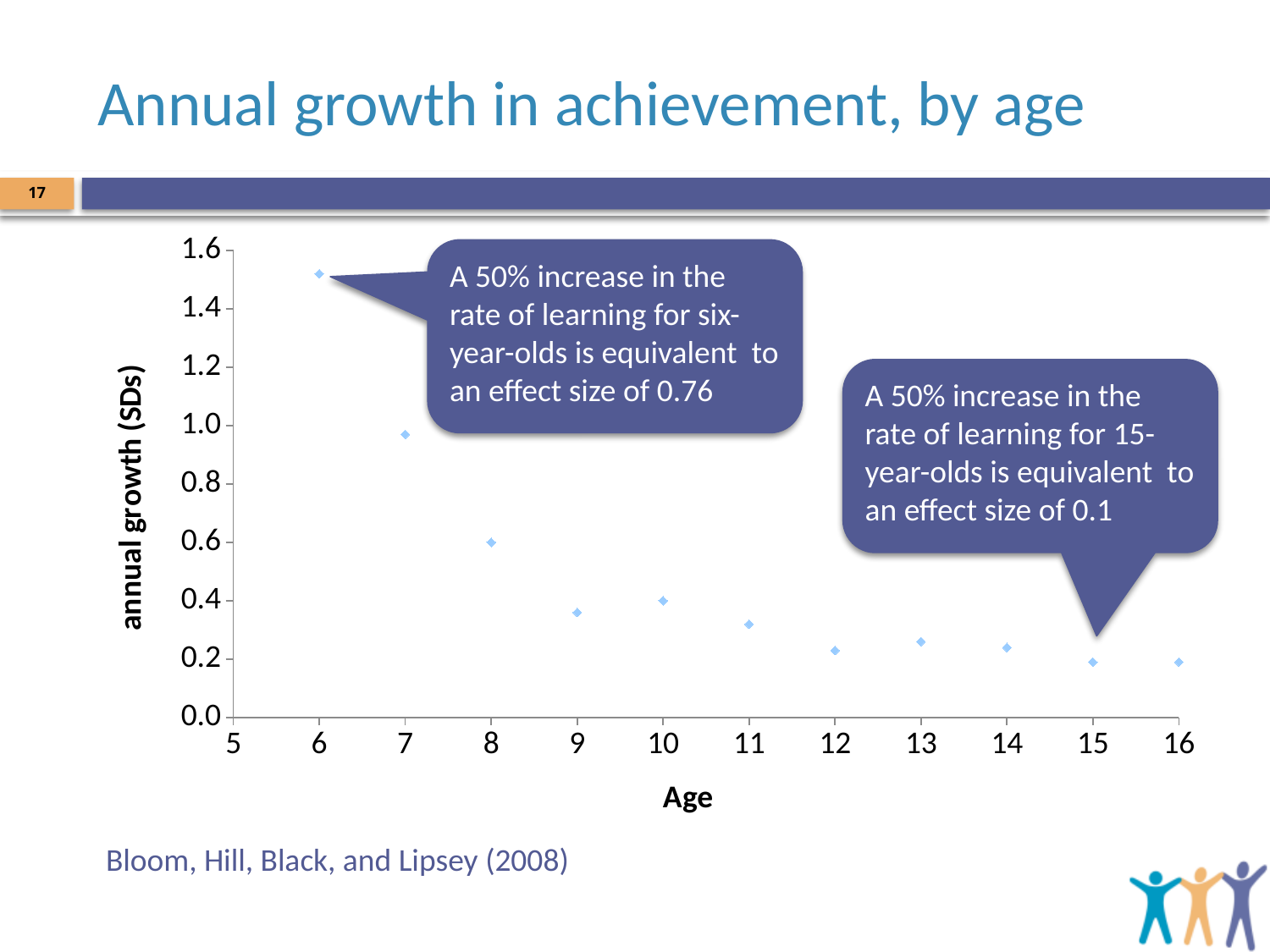
What kind of chart is shown on the slide? scatter plot What is the label on the y axis of the chart? annual growth (SDs) Is the annual growth for age 8 greater or less than 0.8? less Do the values rise or fall as age increases along the x axis? fall Which age has the highest annual growth? 6 Is the annual growth for age 12 greater or less than 0.4? less Is the annual growth for age 6 greater or less than 1.4? greater Which has a larger annual growth, age 6 or age 16? age 6 How many data points are plotted on the chart? 11 Which has a larger annual growth, age 7 or age 8? age 7 What is the title of the chart on the slide? Annual growth in achievement, by age